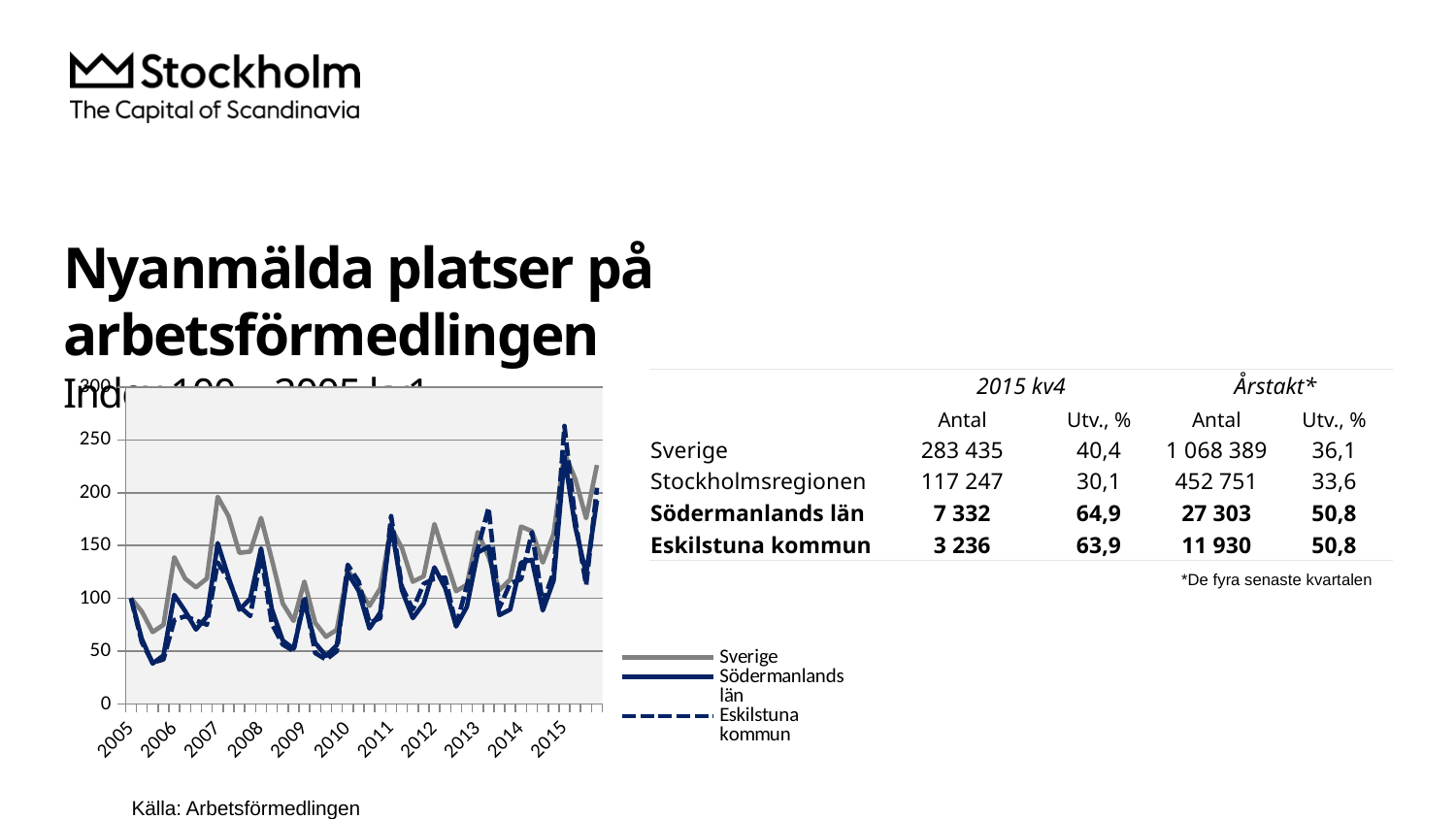
How many year labels are shown on the x axis of the chart? 11 Which series are listed in the chart legend? Sverige, Södermanlands län, Eskilstuna kommun Is the value for Sverige at the start of 2007 greater or less than 150? greater What is the first year shown on the x axis of the chart? 2005 What is the last year shown on the x axis of the chart? 2015 What is the index value of the series at the start of the chart in 2005? 100 Is the lowest value for Södermanlands län around 2006 greater or less than 50? less What kind of chart is shown on the slide? line chart Is the peak value for Sverige near the end of 2015 greater or less than 250? less How many series does the chart legend list? 3 Which series in the chart is drawn with a dashed line? Eskilstuna kommun Overall, do the values in the chart rise or fall from 2005 to 2015? rise